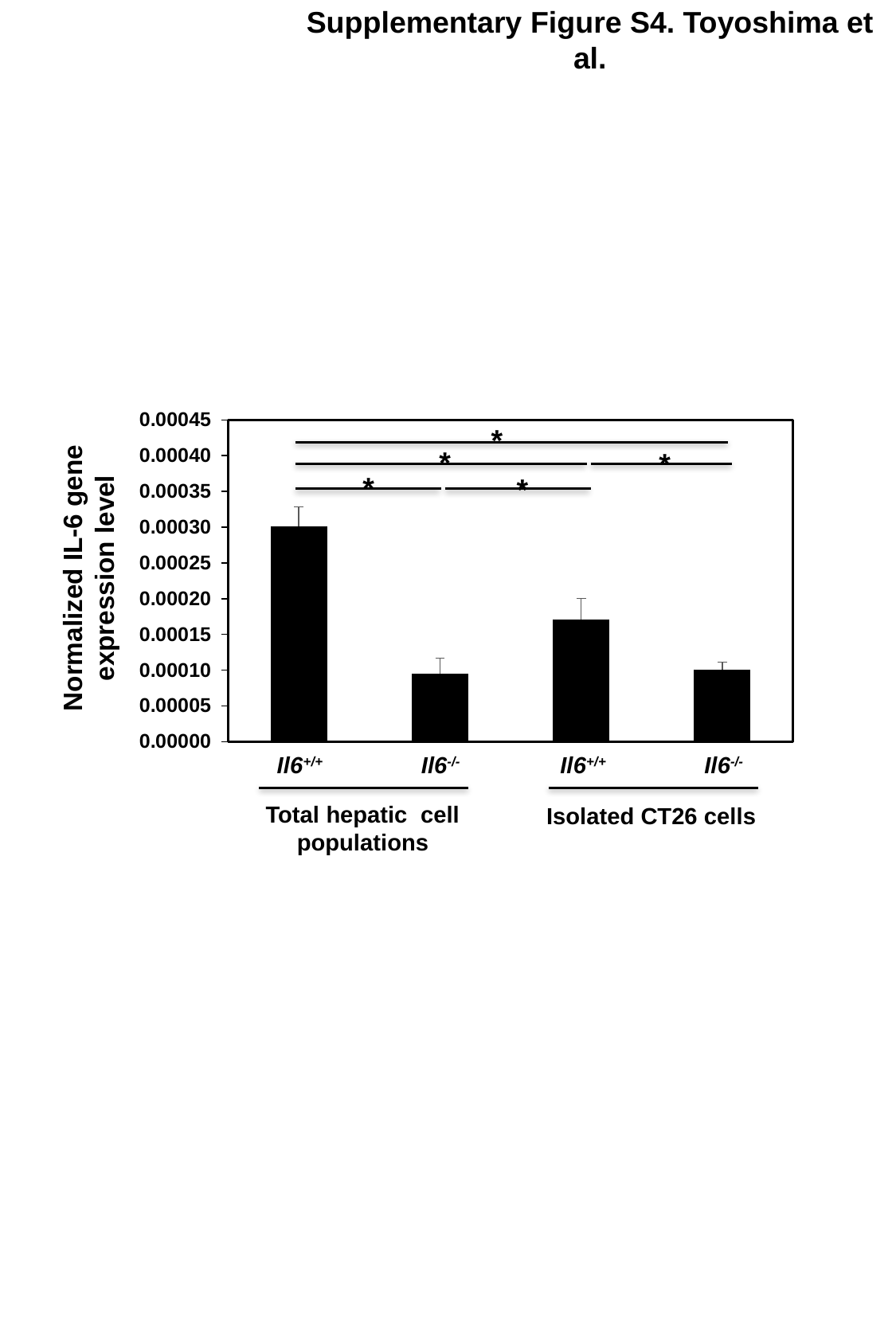
Which bar has the highest normalized IL-6 gene expression level? Il6+/+ in Total hepatic cell populations Is the value for Il6+/+ in Isolated CT26 cells greater or less than 0.00015? greater What kind of chart is shown on the slide? bar chart Which is larger among the Isolated CT26 cells bars: Il6+/+ or Il6-/-? Il6+/+ Is the value for Il6-/- in Isolated CT26 cells greater or less than 0.00020? less Is the value for Il6+/+ in Total hepatic cell populations greater or less than 0.00025? greater What is the label of the y-axis? Normalized IL-6 gene expression level What is the normalized IL-6 gene expression level for Il6+/+ in Total hepatic cell populations? 0.00030 What are the two sample groups labelled below the x-axis? Total hepatic cell populations and Isolated CT26 cells Which is larger: the Il6+/+ bar for Total hepatic cell populations or the Il6+/+ bar for Isolated CT26 cells? Il6+/+ for Total hepatic cell populations How many bars are plotted in the chart? 4